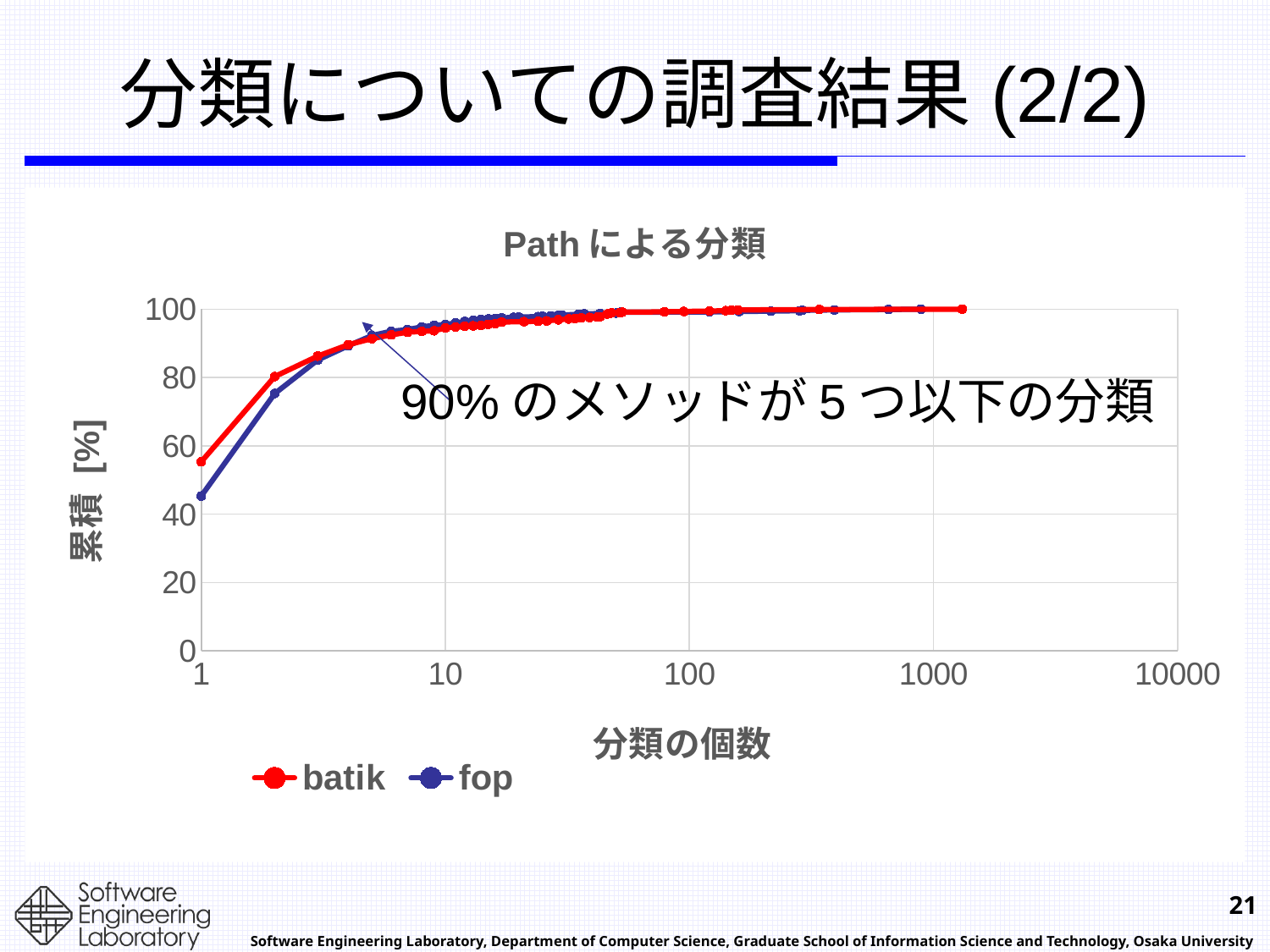
Is the value for fop at x = 1 greater or less than 60? less Is the value for batik at x = 100 greater or less than 80? greater What kind of chart is shown on the slide? line chart What is the highest tick value shown on the x axis? 10000 Is the value for fop at x = 10 greater or less than 80? greater What are the names of the two series in the legend? batik and fop Do the values of the fop series rise or fall along the x axis? rise What is the title of the chart? Path による分類 Do the values of the batik series rise or fall as the number of categories (分類の個数) increases along the x axis? rise At x = 1, which series has the larger value, batik or fop? batik How many series does the legend list? 2